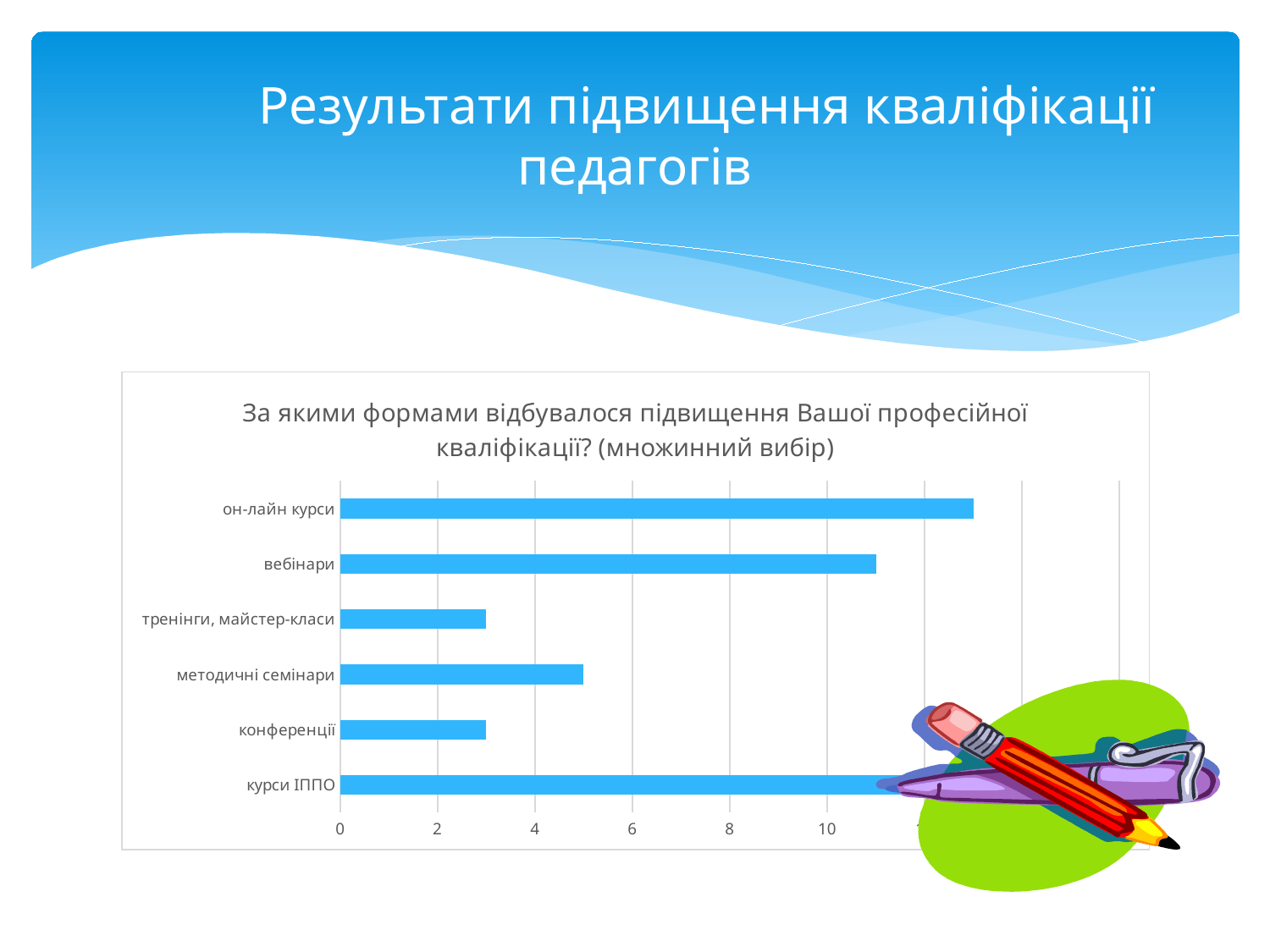
Is the value for "вебінари" greater or less than 10? greater Which has a larger value, "вебінари" or "тренінги, майстер-класи"? вебінари What is the title of the chart? За якими формами відбувалося підвищення Вашої професійної кваліфікації? (множинний вибір) How many categories (forms of professional development) are shown in the chart? 6 What kind of chart is shown on the slide? bar chart Which has a larger value, "методичні семінари" or "конференції"? методичні семінари Is the value for "конференції" greater or less than 4? less Which has a larger value, "он-лайн курси" or "вебінари"? он-лайн курси Is the value for "курси ІППО" greater or less than 10? greater